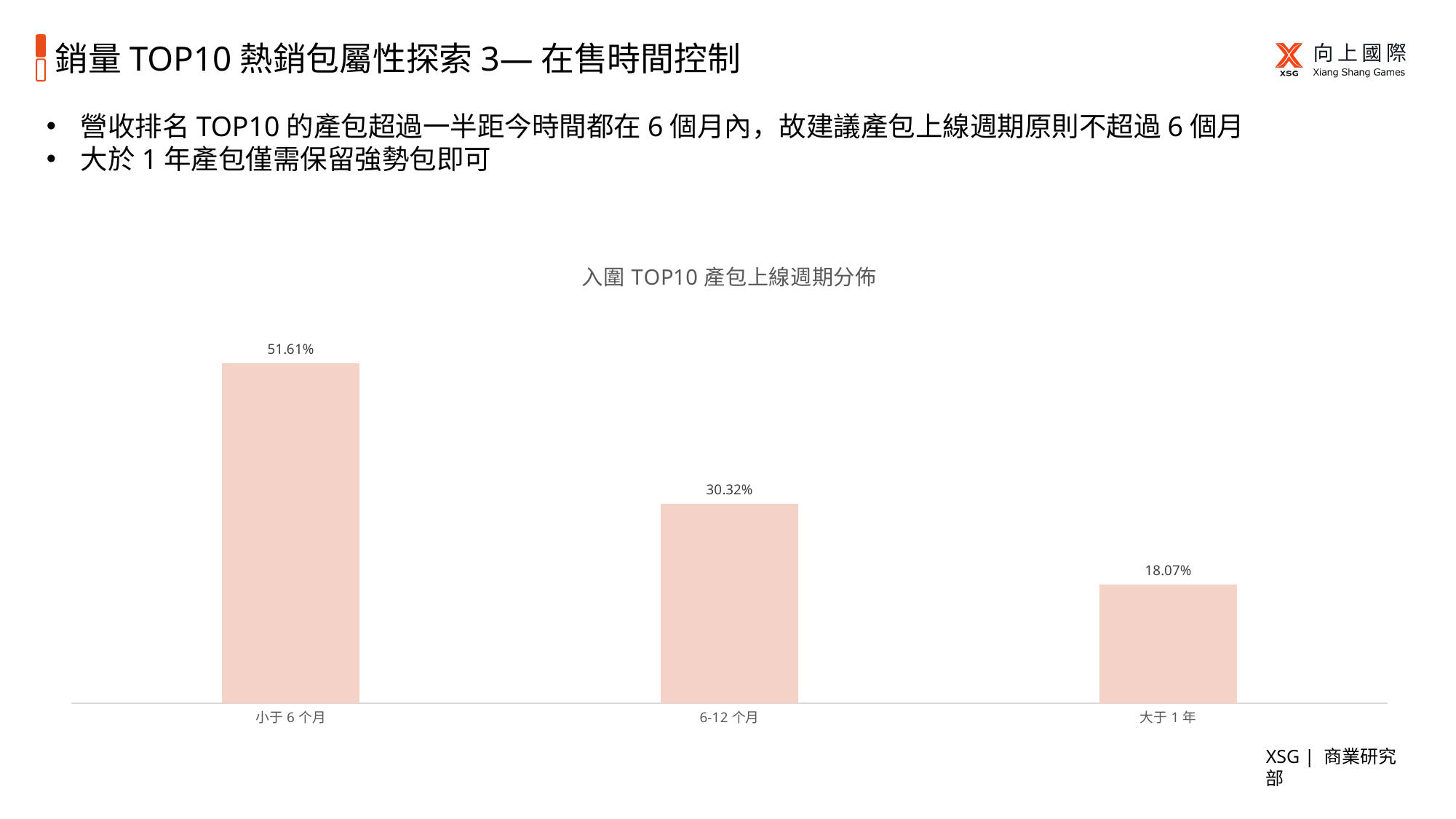
What is the value for 6-12 个月? 30.32% What is the difference between the values for 小于 6 个月 and 6-12 个月? 21.29% Which category has the highest value? 小于 6 个月 Do the values rise or fall from left to right along the x axis? Fall What is the value for 小于 6 个月? 51.61% Which is larger, the value for 6-12 个月 or the value for 大于 1 年? 6-12 个月 What kind of chart is shown on the slide? Bar chart What is the difference between the values for 6-12 个月 and 大于 1 年? 12.25% How many categories are shown in the chart? 3 Which category has the lowest value? 大于 1 年 What is the title of the chart? 入圍 TOP10 產包上線週期分佈 What is the value for 大于 1 年? 18.07%